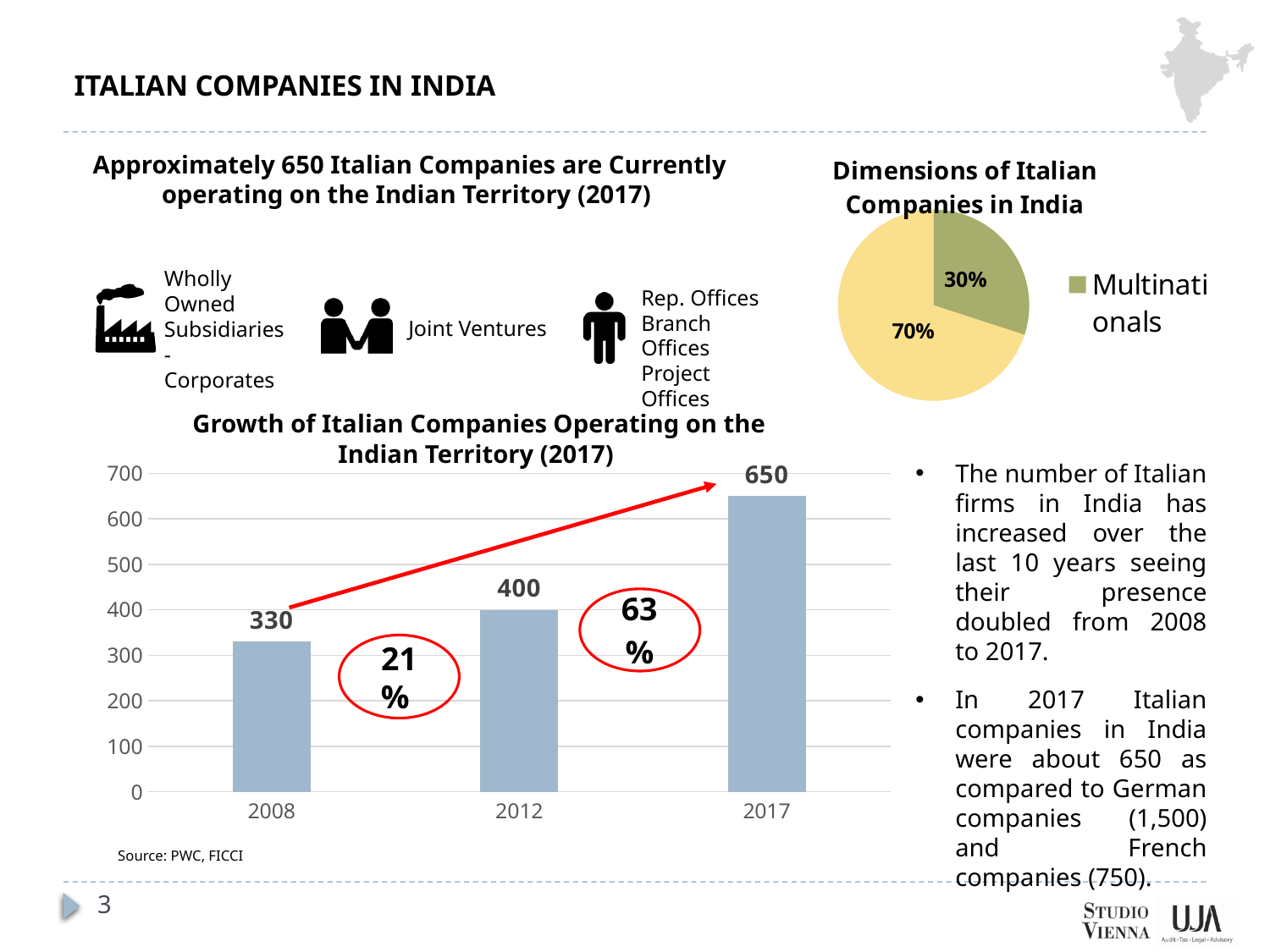
In the bar chart 'Growth of Italian Companies Operating on the Indian Territory (2017)', which year has the highest value? 2017 In the pie chart 'Dimensions of Italian Companies in India', what is the percentage shown on the larger slice? 70% What kind of chart is 'Growth of Italian Companies Operating on the Indian Territory (2017)'? bar chart In the bar chart 'Growth of Italian Companies Operating on the Indian Territory (2017)', what is the value for 2017? 650 In the bar chart 'Growth of Italian Companies Operating on the Indian Territory (2017)', is the value for 2012 larger or smaller than the value for 2017? smaller In the bar chart 'Growth of Italian Companies Operating on the Indian Territory (2017)', what is the value for 2012? 400 In the bar chart 'Growth of Italian Companies Operating on the Indian Territory (2017)', what is the difference between the values for 2017 and 2008? 320 In the bar chart 'Growth of Italian Companies Operating on the Indian Territory (2017)', do the values rise or fall from 2008 to 2017? rise In the pie chart 'Dimensions of Italian Companies in India', what share is labelled for Multinationals? 30% In the bar chart 'Growth of Italian Companies Operating on the Indian Territory (2017)', how many years are shown on the x axis? 3 In the bar chart 'Growth of Italian Companies Operating on the Indian Territory (2017)', what is the value for 2008? 330 In the bar chart 'Growth of Italian Companies Operating on the Indian Territory (2017)', which year has the lowest value? 2008